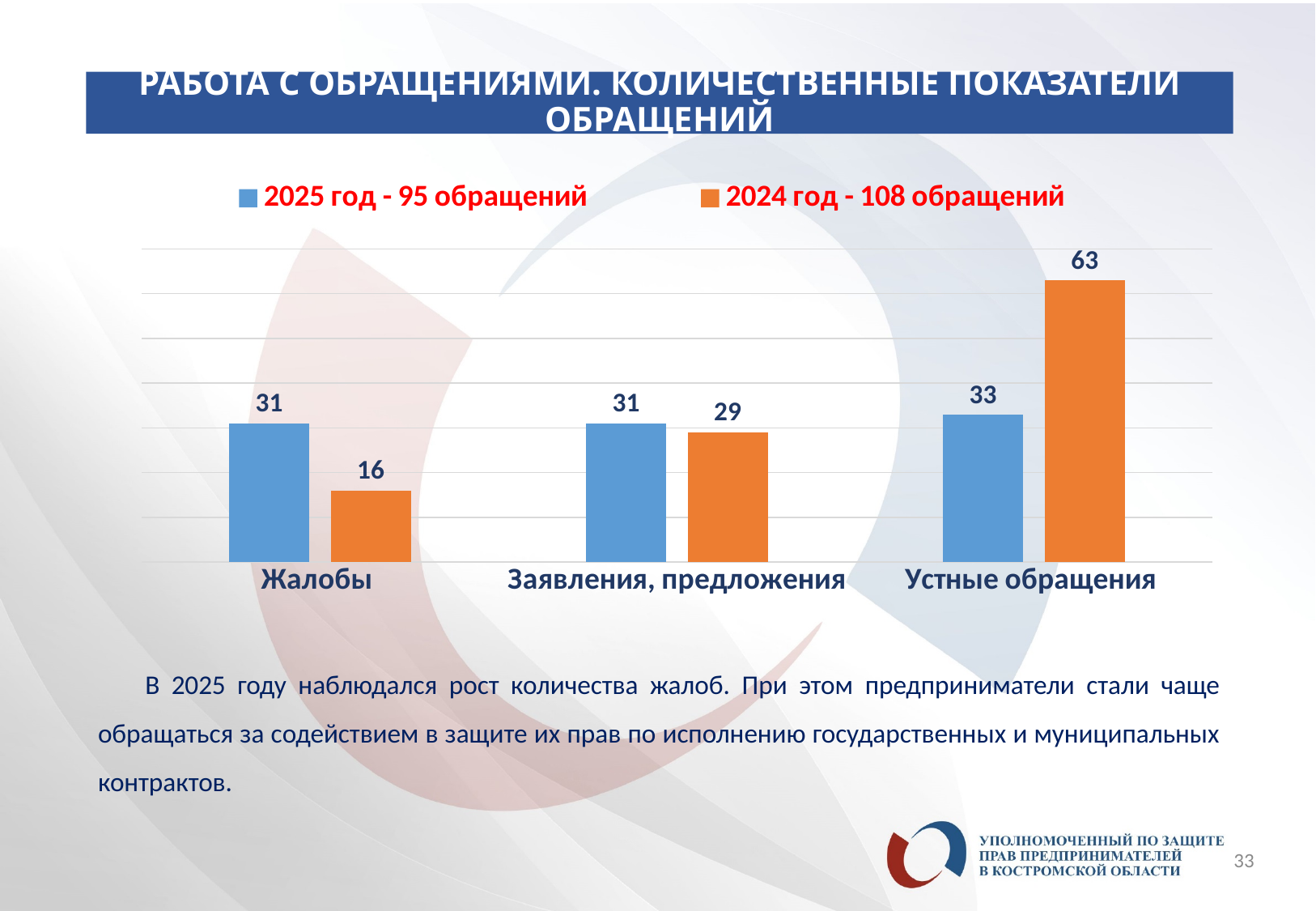
What is the value for Жалобы in the 2025 год series? 31 Which category has the highest value in the 2024 год series? Устные обращения What is the difference between the 2024 and 2025 values for Устные обращения? 30 What is the value for Заявления, предложения in the 2024 год series? 29 How many categories are shown on the x axis? 3 What kind of chart is shown on the slide? bar chart What is the value for Устные обращения in the 2024 год series? 63 What is the value for Жалобы in the 2024 год series? 16 Which is larger for Жалобы: the 2025 год value or the 2024 год value? 2025 год Which category has the lowest value in the 2024 год series? Жалобы How many series does the legend list? 2 According to the legend, how many обращений were there in 2024 год? 108 обращений